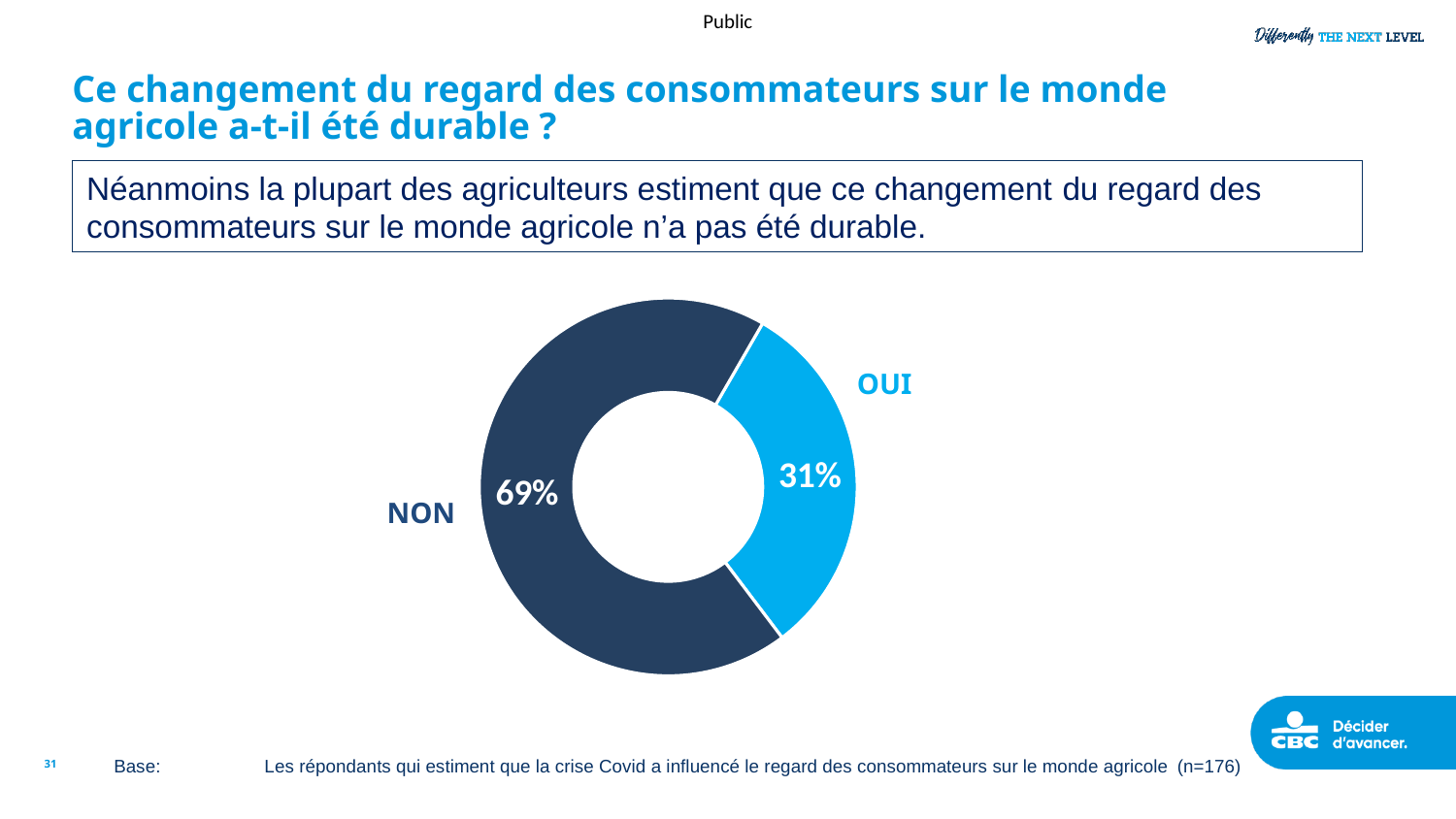
How many categories are shown in the chart? 2 What percentage of respondents answered OUI? 31% What kind of chart is shown on the slide? Doughnut chart What is the difference in percentage points between NON and OUI? 38 What is the total of the two percentages shown in the chart? 100% Which category is shown in light blue? OUI What is the base size (n) of respondents for this chart? n=176 What share of the chart does the OUI slice represent? 31% Which category has the smallest share of the chart? OUI Which is larger, the share for OUI or the share for NON? NON What percentage of respondents answered NON? 69% Which category has the largest share of the chart? NON